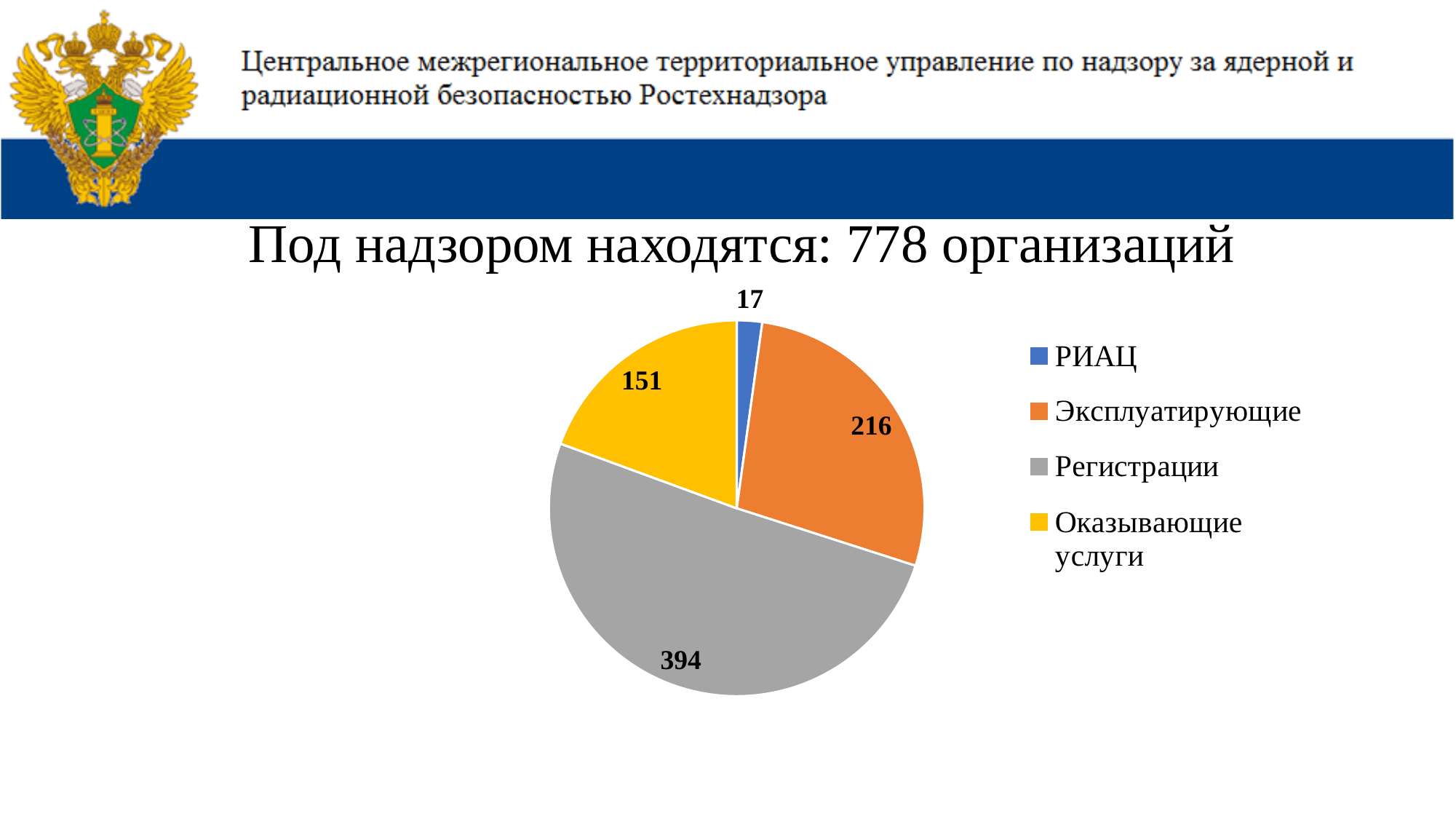
What is the difference between the Регистрации value and the Эксплуатирующие value? 178 Which is larger, the Эксплуатирующие slice or the Оказывающие услуги slice? Эксплуатирующие Which category has the smallest slice of the pie chart? РИАЦ What value is shown for the Оказывающие услуги slice? 151 What value is shown for the РИАЦ slice of the pie chart? 17 What colour is the Регистрации slice in the pie chart? Grey What value is shown for the Эксплуатирующие slice? 216 How many slices does the pie chart have? 4 What is the total of all the slice values in the pie chart? 778 What value is shown for the Регистрации slice? 394 What type of chart is shown on the slide? Pie chart Which category has the largest slice of the pie chart? Регистрации